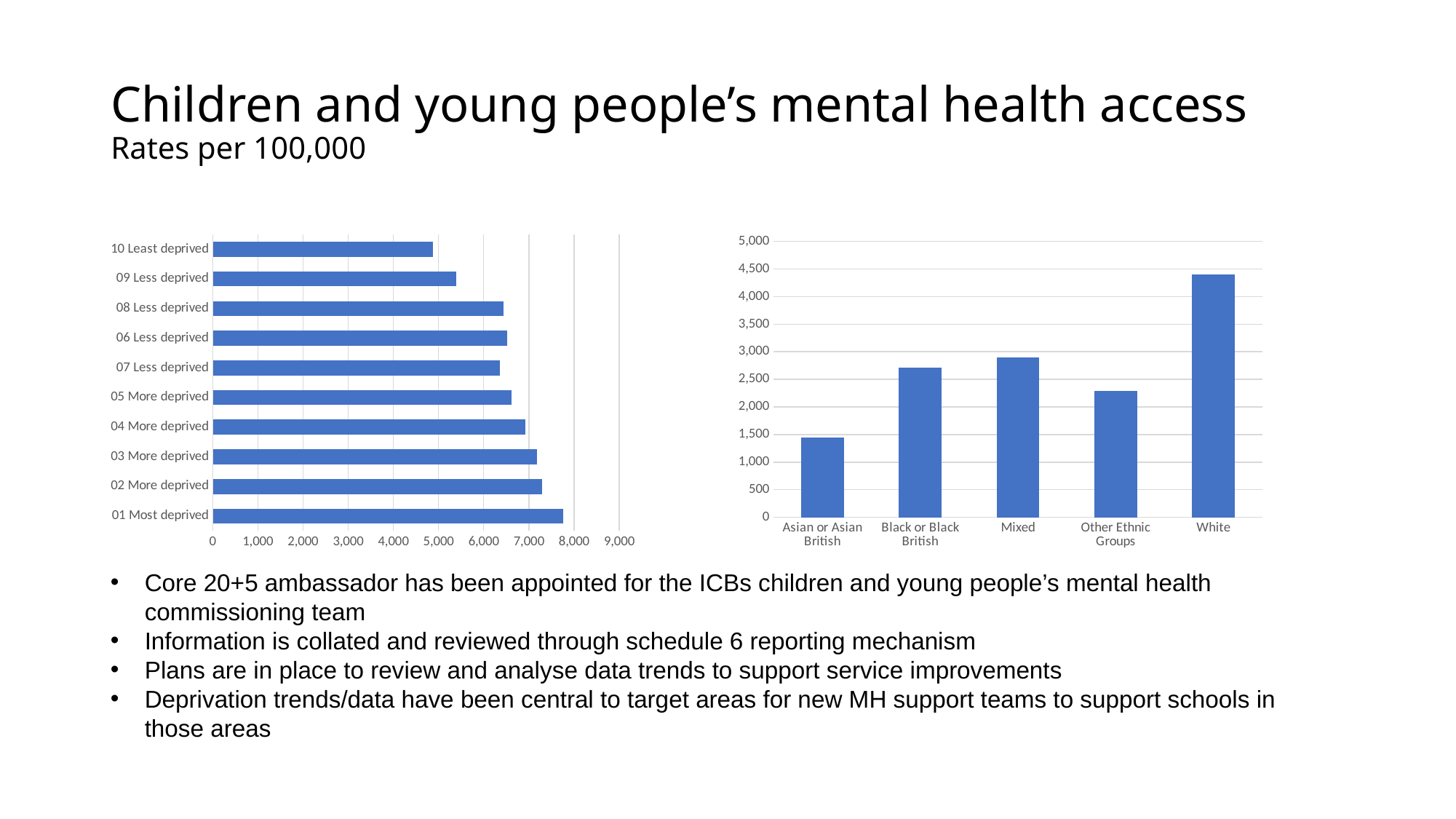
On the right chart, how many ethnic groups are plotted? 5 On the left chart, is the value for 10 Least deprived greater or less than 5,000? less On the right chart, is the value for White greater or less than 4,000? greater On the left chart, how many deprivation categories are plotted? 10 On the left chart, is the value for 01 Most deprived greater or less than 7,000? greater On the right chart, which is larger, the value for White or the value for Mixed? White On the right chart, which ethnic group has the lowest rate? Asian or Asian British On the left chart, which deprivation decile has the highest rate? 01 Most deprived What kind of chart is the left chart? bar chart On the right chart, which ethnic group has the highest rate? White On the left chart, which deprivation decile has the lowest rate? 10 Least deprived